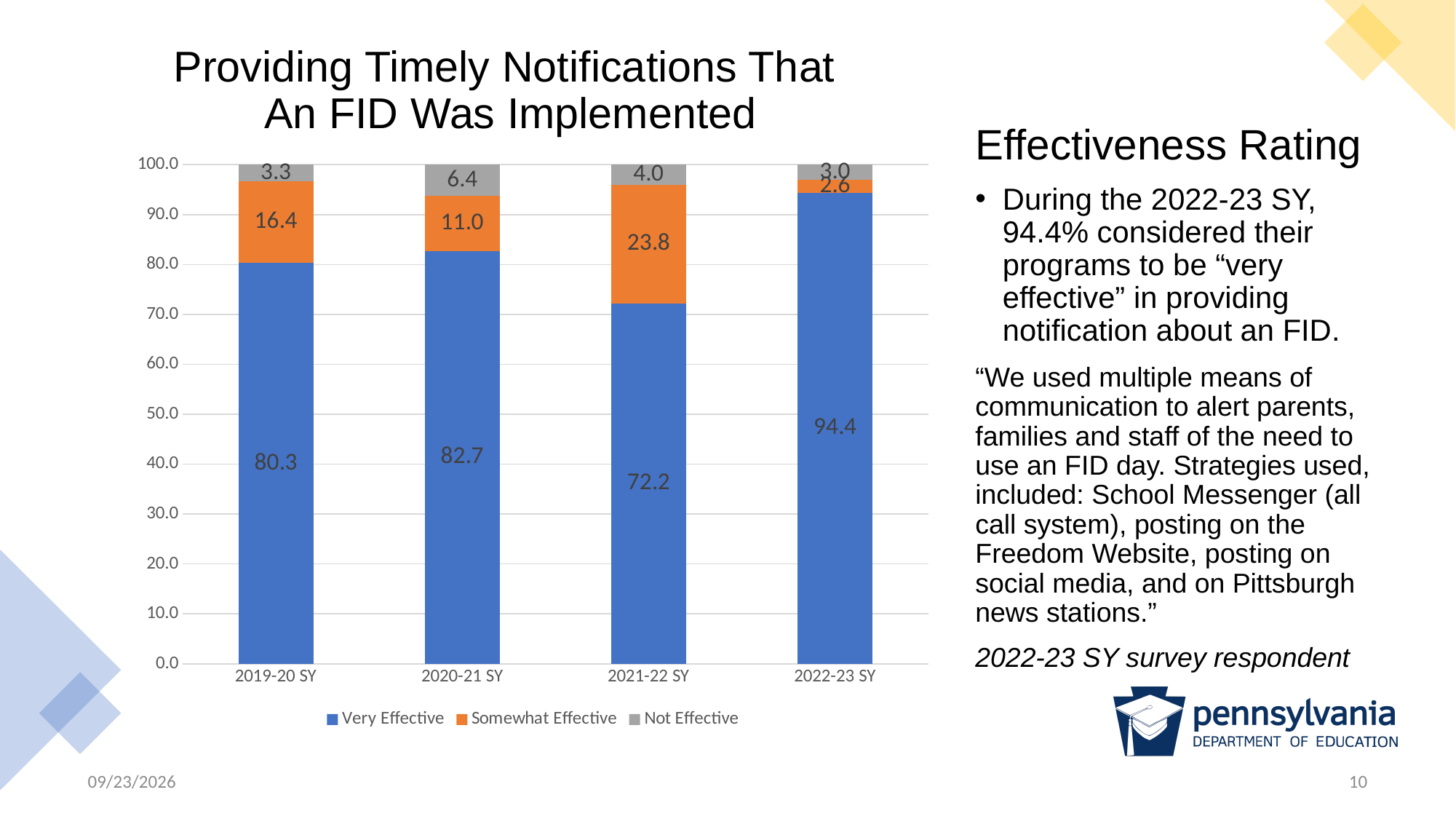
What is the Somewhat Effective value for 2021-22 SY? 23.8 What is the Not Effective value for 2020-21 SY? 6.4 What is the difference between the Very Effective values for 2022-23 SY and 2021-22 SY? 22.2 What is the Very Effective value for 2022-23 SY? 94.4 Which series is shown in orange in the chart? Somewhat Effective What kind of chart is shown on the slide? Stacked bar chart Which school year has the lowest Very Effective value? 2021-22 SY Which school year has the highest Very Effective value? 2022-23 SY How many series does the chart legend list? 3 What is the total of the stacked bar for 2019-20 SY? 100.0 How many school years are shown on the x axis of the chart? 4 Which is larger, the Somewhat Effective value for 2019-20 SY or for 2020-21 SY? 2019-20 SY